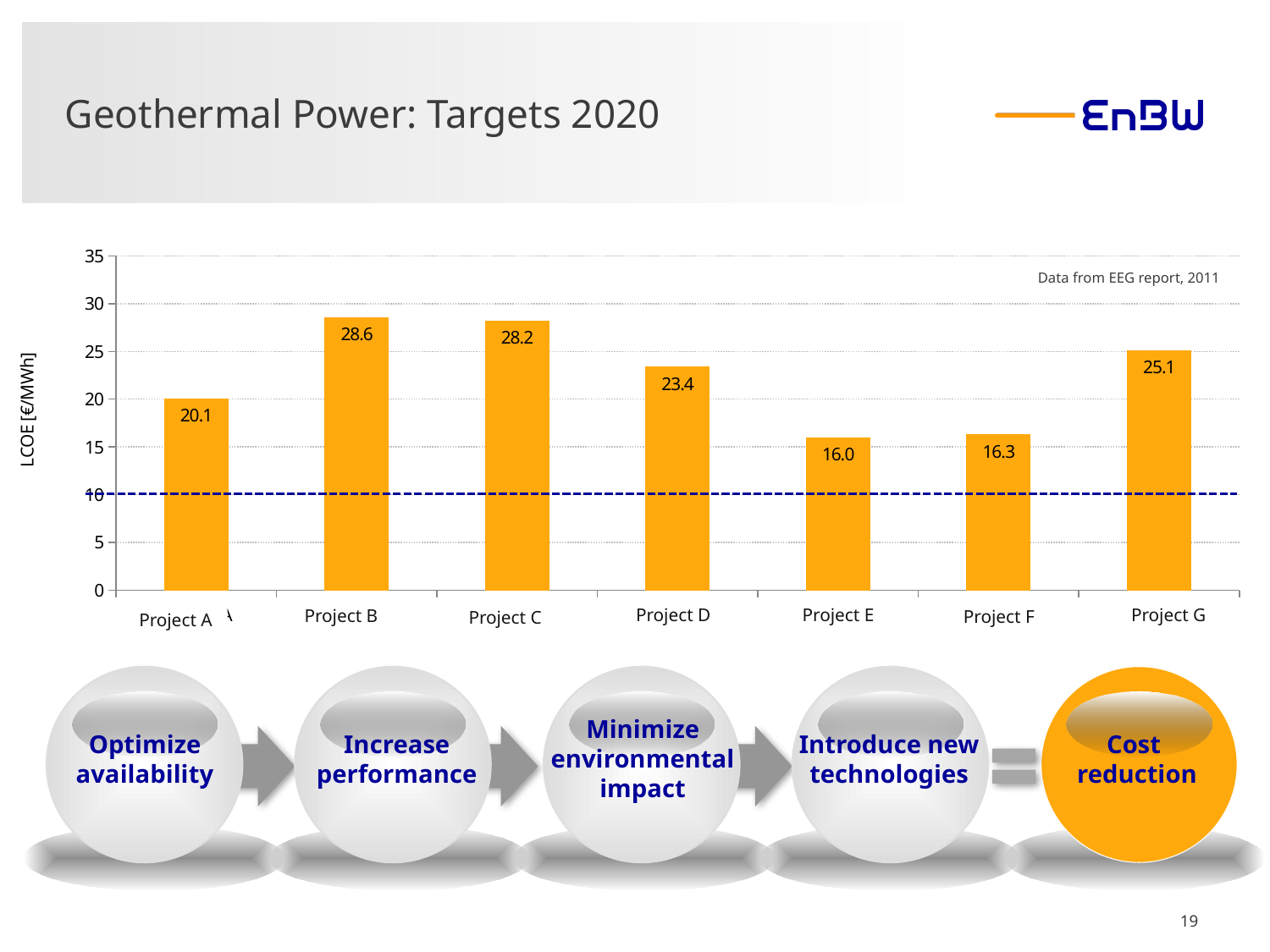
What is the LCOE value for Project E? 16.0 What is the label of the y-axis of the chart? LCOE [€/MWh] What is the LCOE value for Project G? 25.1 What is the LCOE value for Project B? 28.6 Is the value for Project A greater or less than 15? greater Which has a higher LCOE, Project F or Project G? Project G How many projects are shown in the chart? 7 What kind of chart is shown on the slide? Bar chart Which project has the highest LCOE? Project B What is the difference between the LCOE of Project D and Project A? 3.3 Which project has the lowest LCOE? Project E What is the difference between the LCOE of Project B and Project C? 0.4